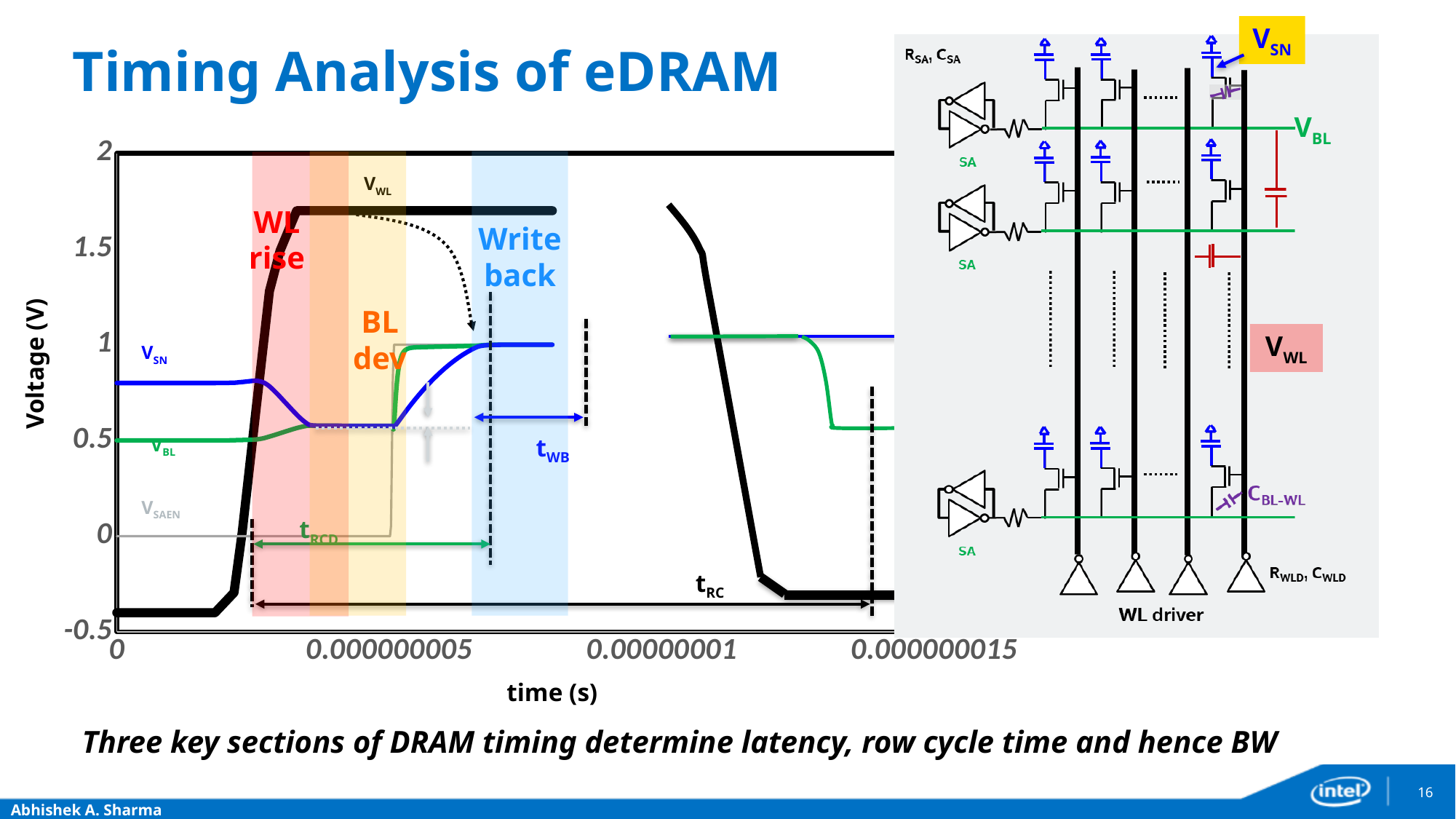
Is the initial value of V_SN at time 0 greater or less than 0.5 V? greater At time 0, which trace has the higher voltage, V_SN or V_BL? V_SN Is the plateau value of V_WL after the word line rises greater or less than 1.5 V? greater Does V_WL rise or fall during the highlighted 'WL rise' section? rise Is the initial value of V_WL at time 0 greater or less than 0 V? less What is the highest value shown on the y axis of the voltage chart? 2 Which trace reaches the highest voltage on the chart? V_WL How many voltage traces are labelled on the chart (V_WL, V_SN, V_BL, V_SAEN)? 4 What kind of chart is shown on the left of the slide? line chart What is the label of the x axis of the voltage chart? time (s) What is the label of the y axis of the voltage chart? Voltage (V)